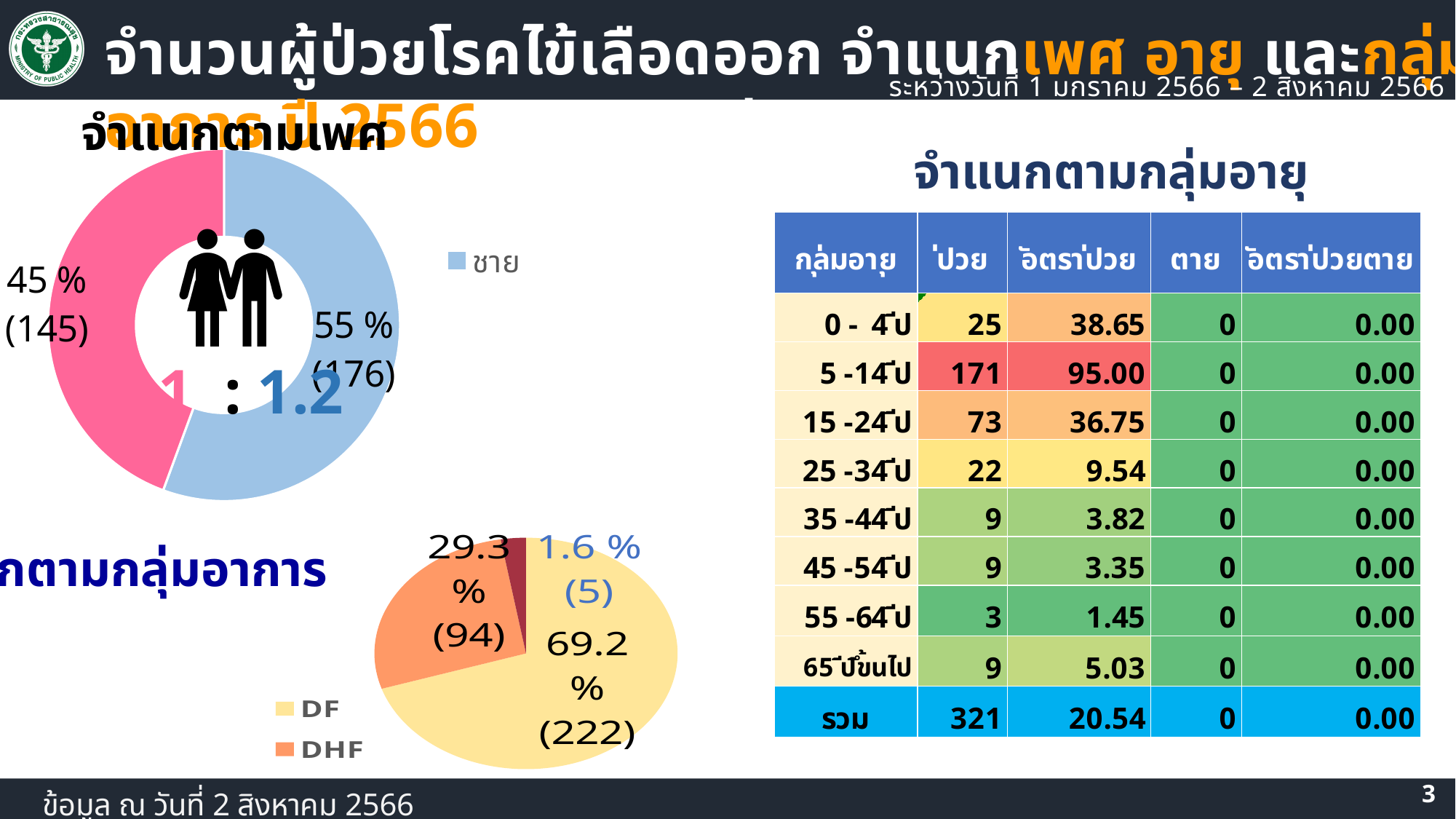
In the symptom-group pie chart, what share is shown for DF? 69.2 % In the symptom-group pie chart, which category has the largest slice? DF In the symptom-group pie chart, how many cases are shown for DHF? 94 In the gender donut chart (จำแนกตามเพศ), what percentage is shown for ชาย? 55 % In the symptom-group pie chart, what is the share of the smallest slice? 1.6 % In the symptom-group pie chart, what is the difference in cases between DF and DHF? 128 In the gender donut chart (จำแนกตามเพศ), what is the difference in cases between the 55 % slice and the 45 % slice? 31 In the symptom-group pie chart, which is larger, DF or DHF? DF In the gender donut chart (จำแนกตามเพศ), how many cases are shown for the pink (45 %) slice? 145 In the gender donut chart (จำแนกตามเพศ), how many cases are shown for ชาย? 176 In the gender donut chart (จำแนกตามเพศ), what ratio is printed in the centre of the chart? 1 : 1.2 What type of chart is used for the symptom-group breakdown (จำแนกตามกลุ่มอาการ)? pie chart